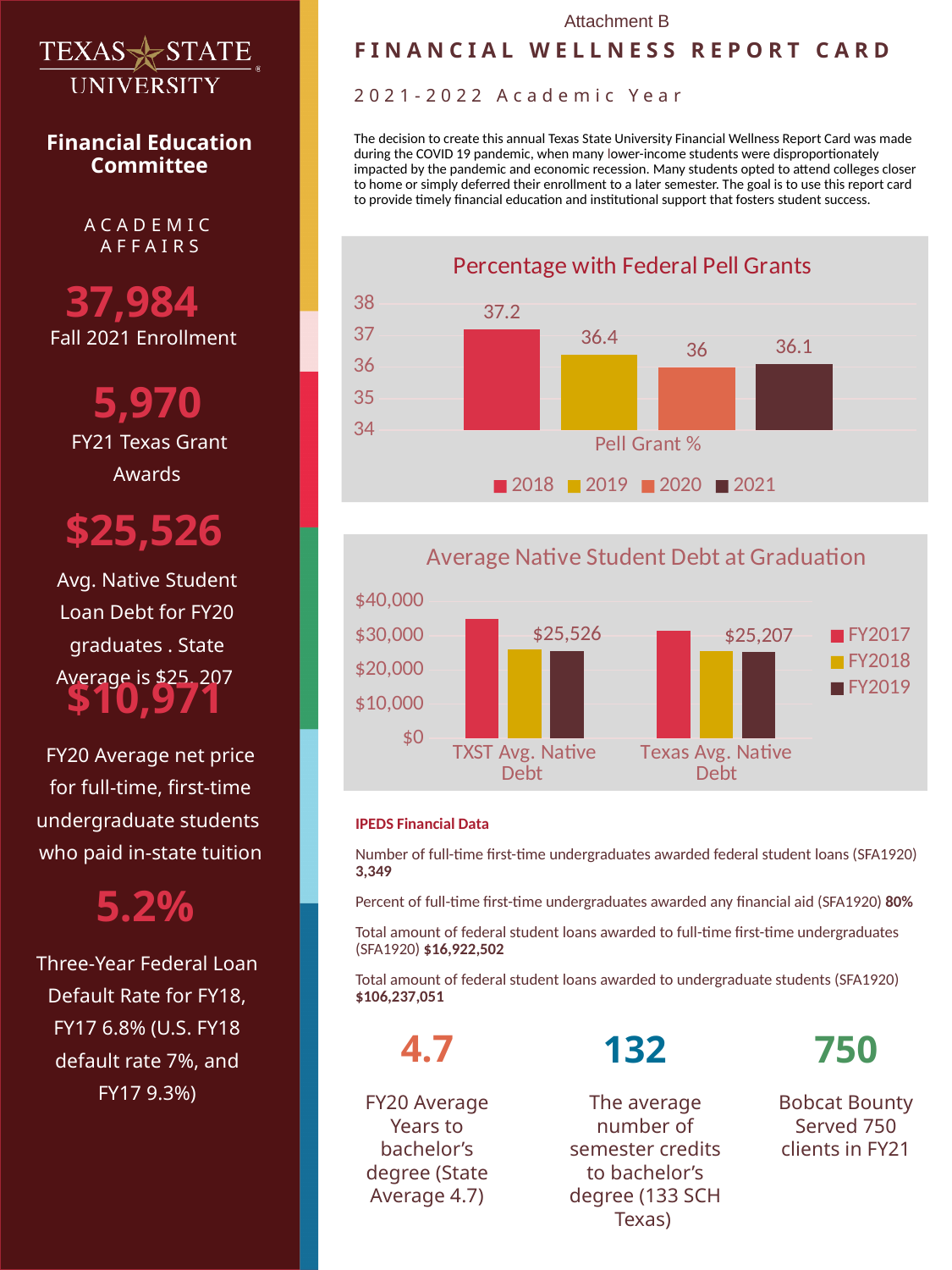
What kind of chart is 'Percentage with Federal Pell Grants'? Bar chart In the 'Average Native Student Debt at Graduation' chart, is the FY2017 value for TXST Avg. Native Debt greater or less than $30,000? greater In the 'Percentage with Federal Pell Grants' chart, is the value for 2019 greater or less than 37? less In the 'Percentage with Federal Pell Grants' chart, which year has the lowest Pell Grant percentage? 2020 In the 'Average Native Student Debt at Graduation' chart, which is larger for TXST Avg. Native Debt: FY2017 or FY2018? FY2017 In the 'Average Native Student Debt at Graduation' chart, how many series does the legend list? 3 In the 'Average Native Student Debt at Graduation' chart, what data label is shown for the Texas Avg. Native Debt group? $25,207 In the 'Percentage with Federal Pell Grants' chart, what is the difference between the 2018 and 2019 values? 0.8 In the 'Percentage with Federal Pell Grants' chart, what is the value for 2020? 36 In the 'Percentage with Federal Pell Grants' chart, how many years does the legend list? 4 In the 'Percentage with Federal Pell Grants' chart, which year has the highest Pell Grant percentage? 2018 In the 'Percentage with Federal Pell Grants' chart, what is the value for 2018? 37.2